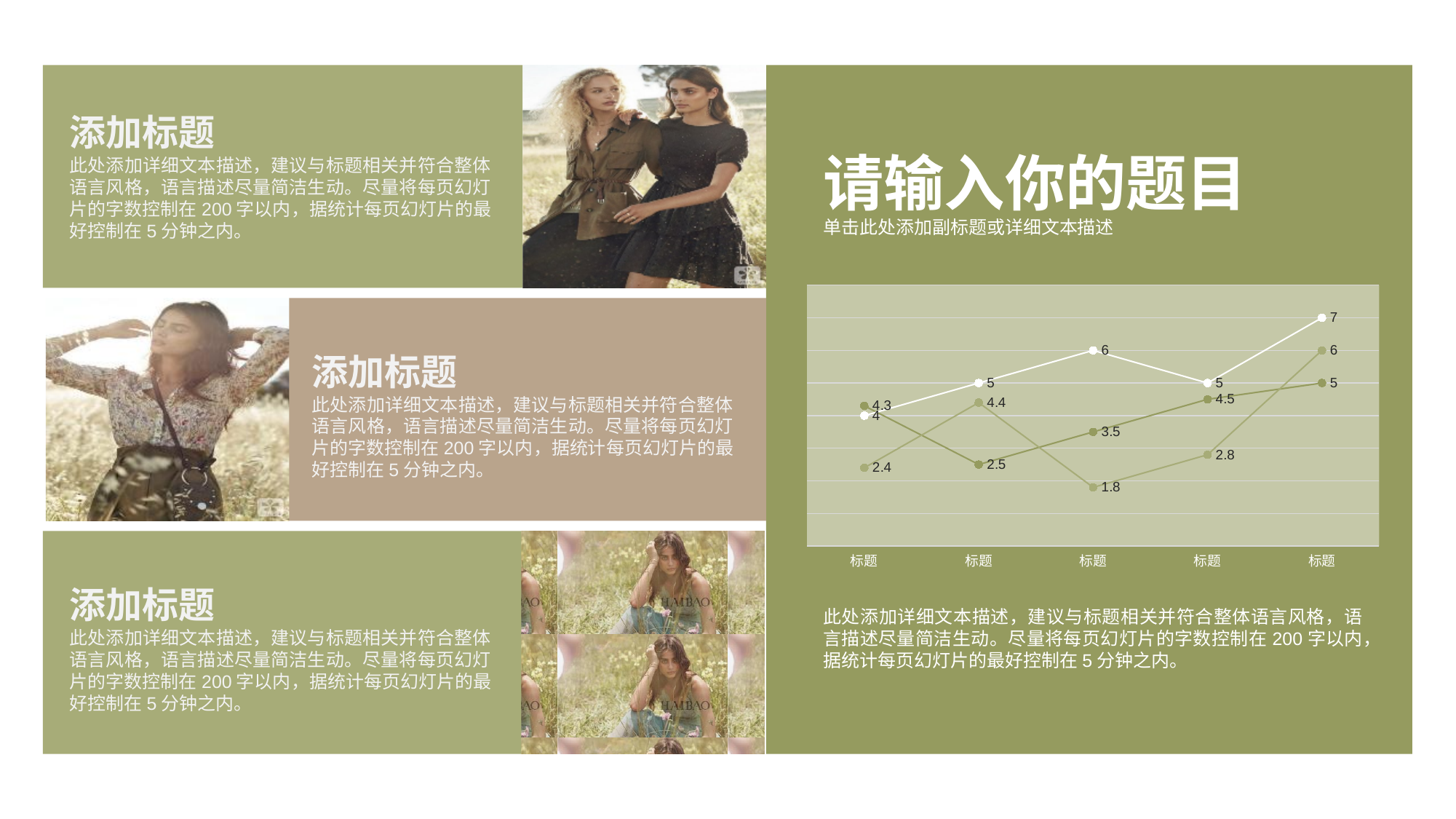
What is the value of the white line at the first category? 4 What is the highest value labelled on the chart? 7 What label is repeated for every category on the x axis? 标题 What is the value of the white line at the last (fifth) category? 7 Does the white line end higher or lower at the last category than it starts at the first category? higher What is the difference between the white line's value at the fifth category (7) and its value at the first category (4)? 3 At the third category, which is larger: the white line's value or the value 1.8 of the lighter green line? the white line's value (6) What is the value of the darker green line at the first category? 4.3 What kind of chart is shown on the right side of the slide? line chart What is the lowest value labelled on the chart? 1.8 How many categories are shown along the x axis of the chart? 5 How many lines are plotted in the chart? 3